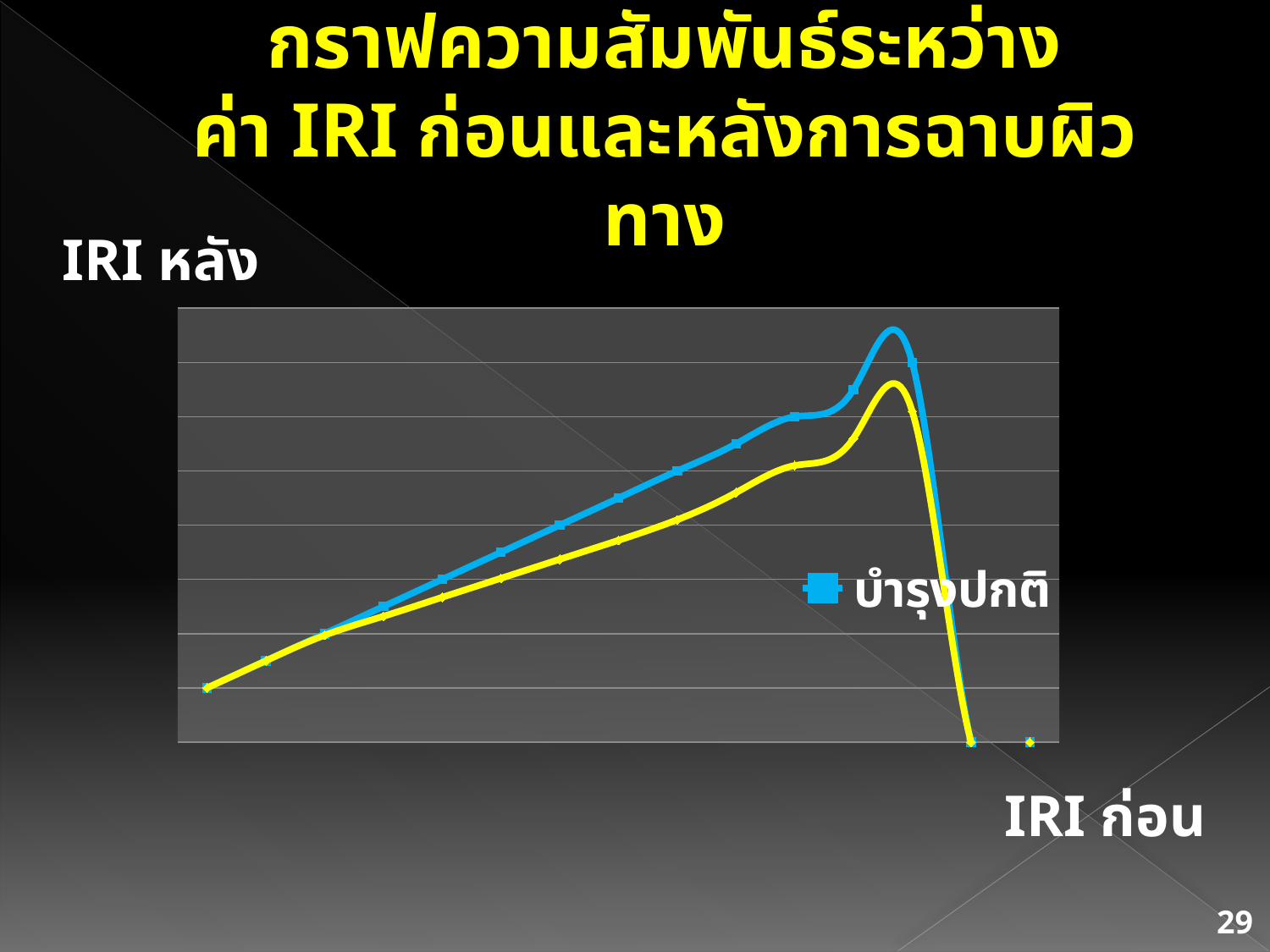
Do the plotted lines rise or fall along the x axis before their peak near the right side? rise Which line is higher across most of the chart, the blue line or the yellow line? the blue line After reaching their peak near the right side, do the lines rise or fall? fall Which line reaches the higher peak, the blue line or the yellow line? the blue line What label is shown on the vertical axis of the chart? IRI หลัง What is the legend entry shown on the chart? บำรุงปกติ What kind of chart is shown on the slide? line chart How many series does the chart's legend list? 1 How many lines are plotted on the chart? 2